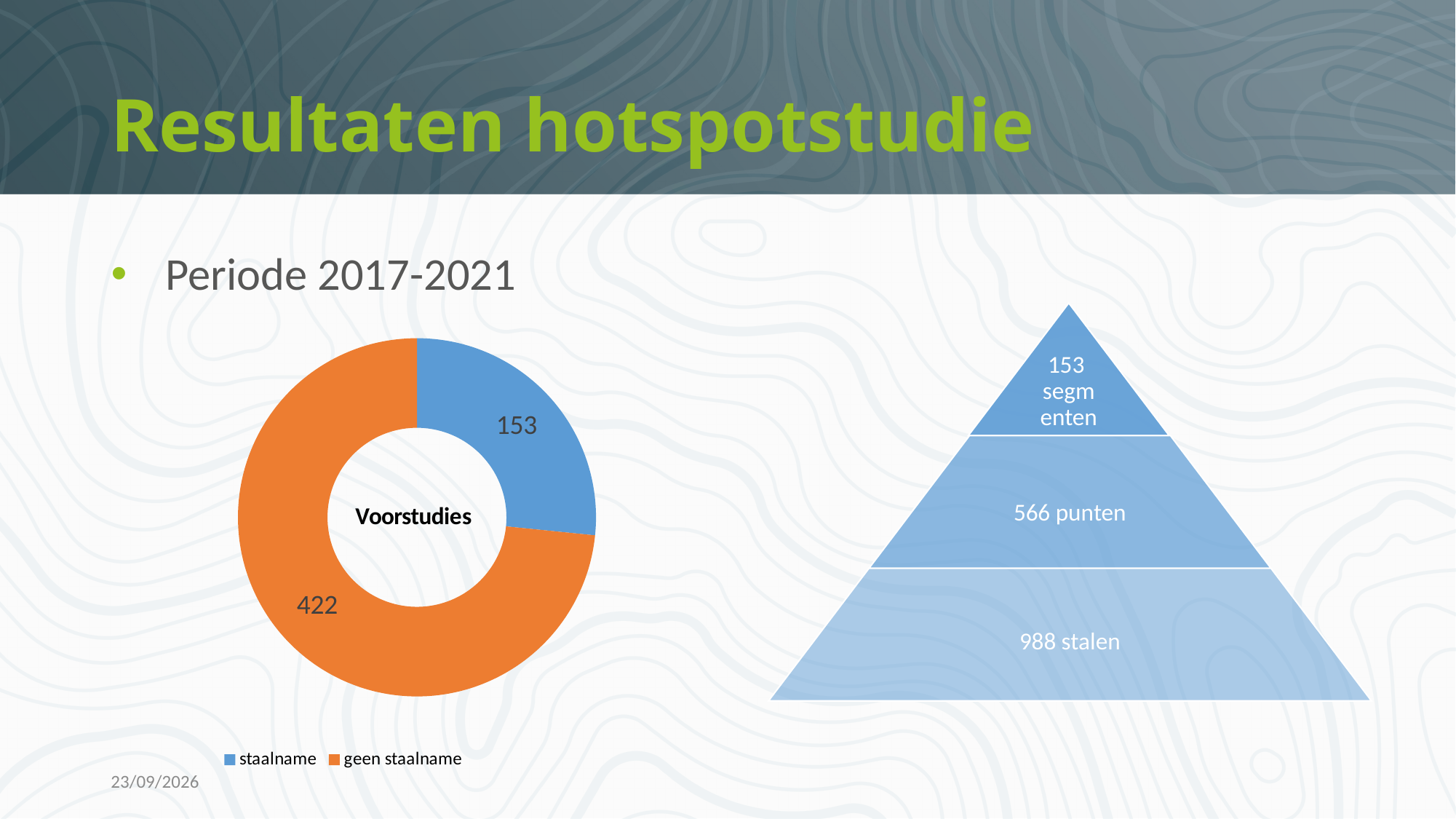
In the Voorstudies doughnut chart, what is the value for geen staalname? 422 In the Voorstudies doughnut chart, which category has the smallest value? staalname Which colour represents geen staalname in the doughnut chart? orange In the Voorstudies doughnut chart, which category has the largest value? geen staalname In the Voorstudies doughnut chart, is the value for staalname larger or smaller than the value for geen staalname? smaller What is the total of the two values in the Voorstudies doughnut chart? 575 In the Voorstudies doughnut chart, what is the value for staalname? 153 What kind of chart is shown on the left of the slide? doughnut chart In the Voorstudies doughnut chart, what is the difference between geen staalname and staalname? 269 How many categories does the Voorstudies doughnut chart show? 2 What text is shown in the centre of the doughnut chart? Voorstudies How many entries does the legend of the Voorstudies doughnut chart list? 2